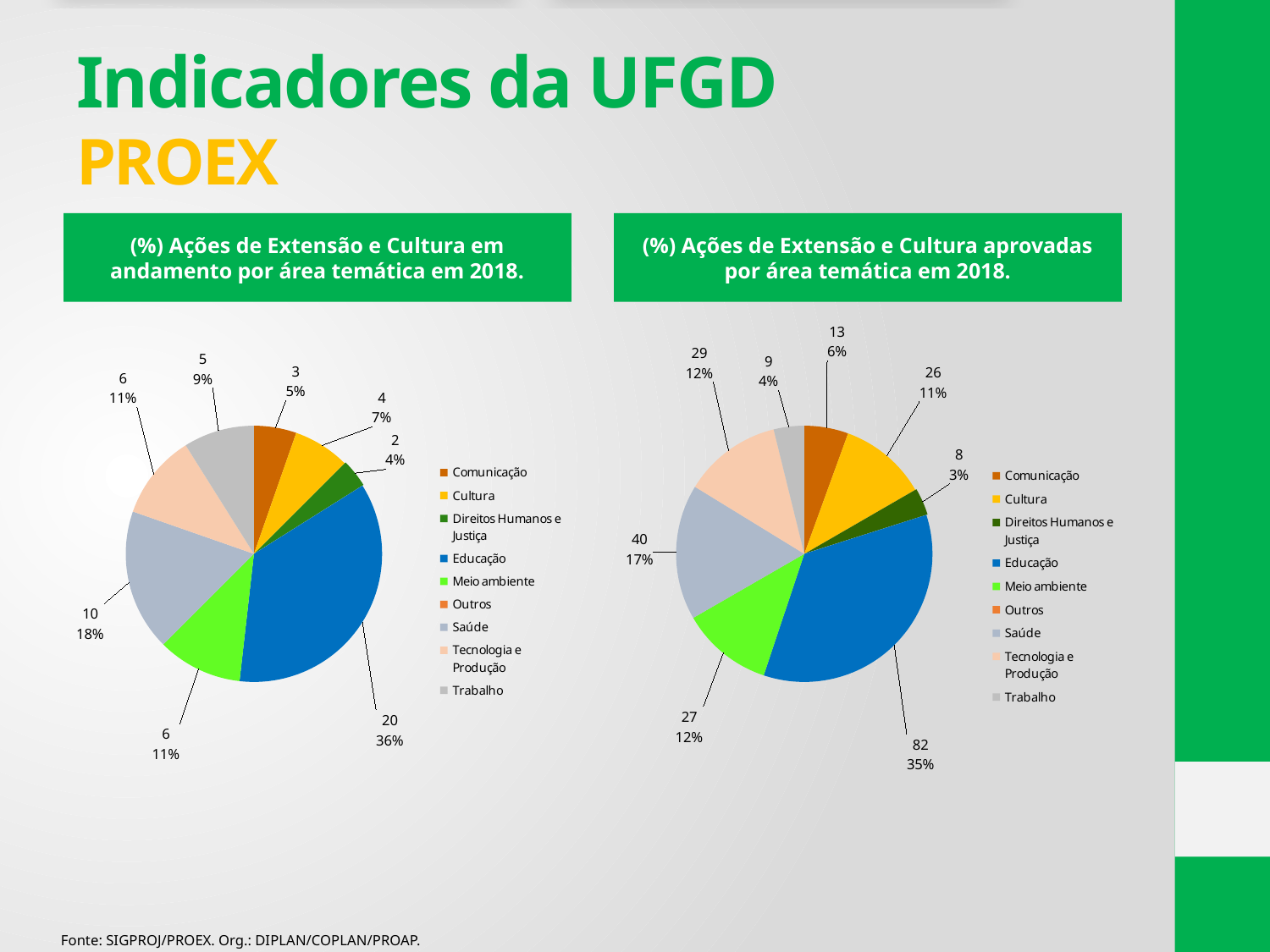
In the left pie chart (Ações em andamento), which area has the smallest slice? Direitos Humanos e Justiça In the left pie chart (Ações em andamento), what percentage share does Educação have? 36% In the left pie chart (Ações em andamento), what colour represents Educação? Blue In the right pie chart (Ações aprovadas), which is larger, the value for Cultura or the value for Comunicação? Cultura In the right pie chart (Ações aprovadas), what percentage share does Saúde have? 17% How many series does the legend of the right pie chart (Ações aprovadas) list? 9 In the right pie chart (Ações aprovadas), what is the difference between the values for Educação and Saúde? 42 In the right pie chart (Ações aprovadas), what is the value shown for Educação? 82 In the left pie chart (Ações em andamento), which is larger, the value for Cultura or the value for Trabalho? Trabalho What type of chart is used for Ações de Extensão e Cultura em andamento por área temática em 2018? Pie chart In the right pie chart (Ações aprovadas), which area has the largest slice? Educação In the left pie chart (Ações em andamento), what is the value shown for Saúde? 10